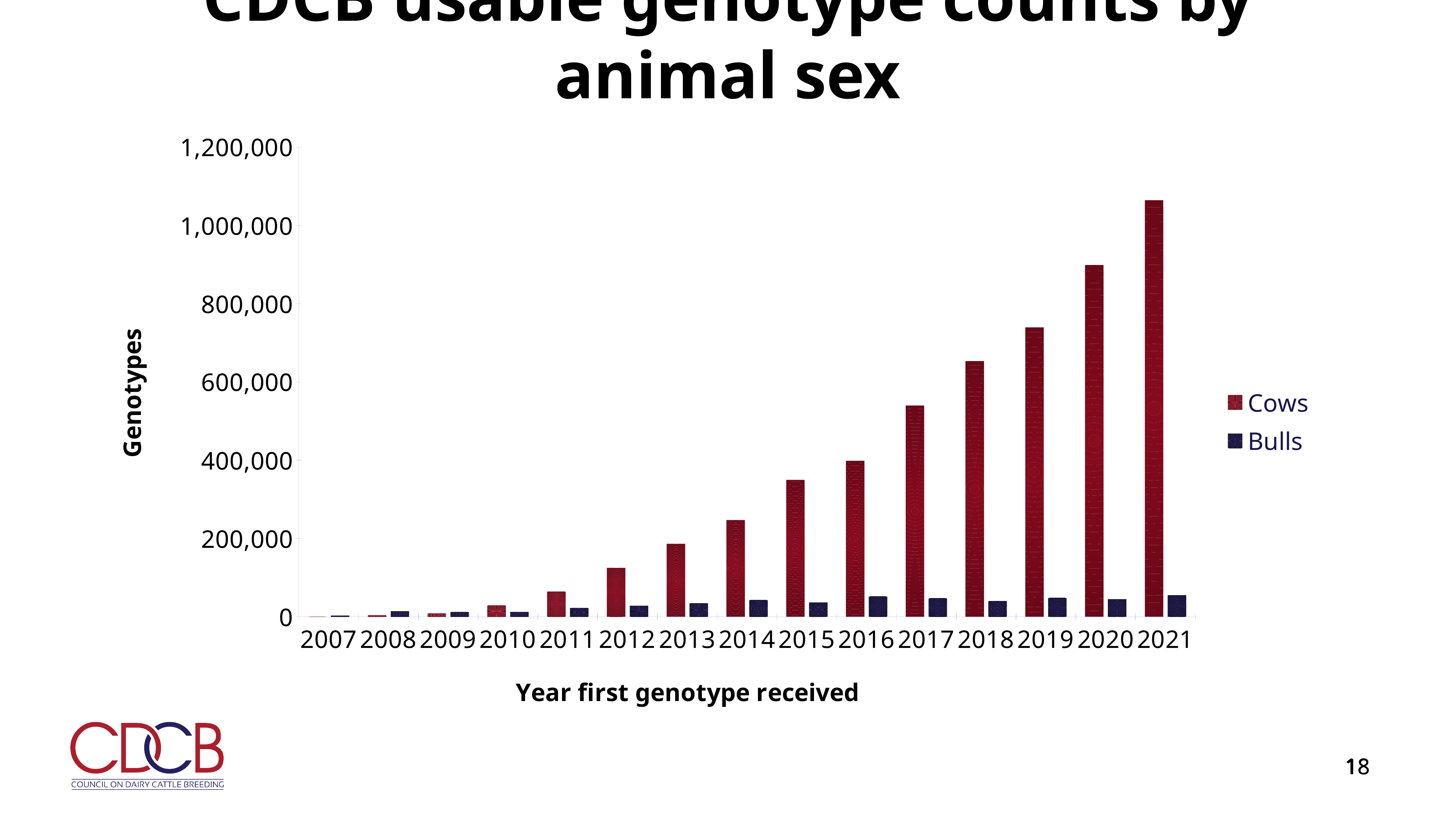
Is the value for Cows in 2017 greater or less than 400,000? greater Do the values for Cows rise or fall from 2007 to 2021? rise Is the value for Cows in 2021 greater or less than 1,000,000? greater What is the title of the x axis? Year first genotype received How many years are shown on the x axis? 15 Which year has the highest value for Cows? 2021 Is the value for Bulls in 2021 greater or less than 200,000? less Which year has the lowest value for Cows? 2007 What kind of chart is shown on the slide? bar chart How many series does the legend list? 2 In 2021, which is larger, the value for Cows or the value for Bulls? Cows